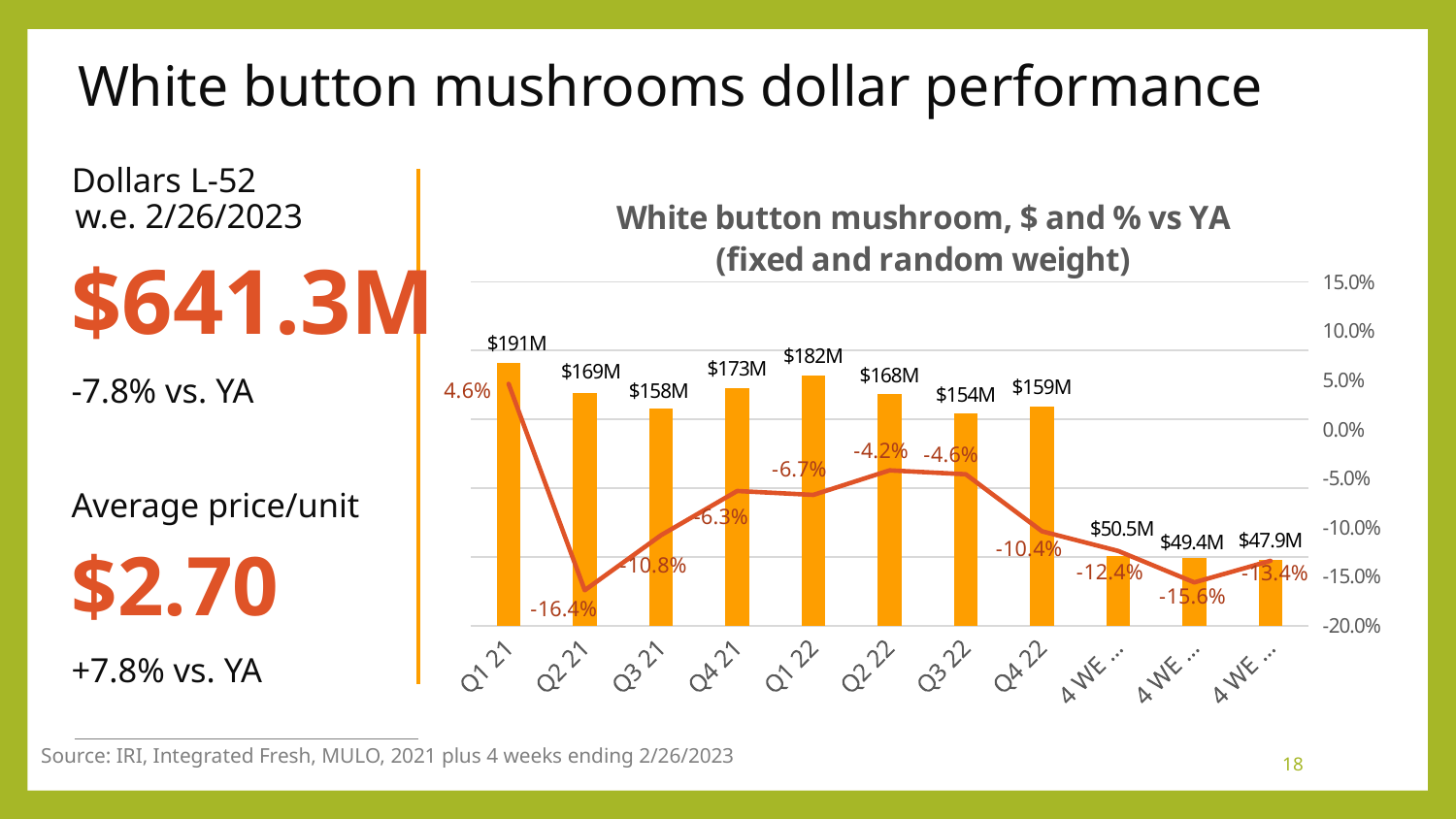
Which quarter has the lowest % vs YA value? Q2 21 What is the difference in dollar value between Q1 21 and Q2 21? $22M What is the dollar value for Q1 21? $191M What is the % vs YA value for Q2 22? -4.2% What is the % vs YA value for Q2 21? -16.4% How many bars are plotted in the chart? 11 What is the title of the chart? White button mushroom, $ and % vs YA (fixed and random weight) Which has a larger dollar value, Q4 21 or Q3 22? Q4 21 Which quarter has the highest dollar value? Q1 21 What is the dollar value for Q1 22? $182M Is the % vs YA value for Q4 22 greater or less than -5.0%? less What kind of chart is shown? Bar chart with a line